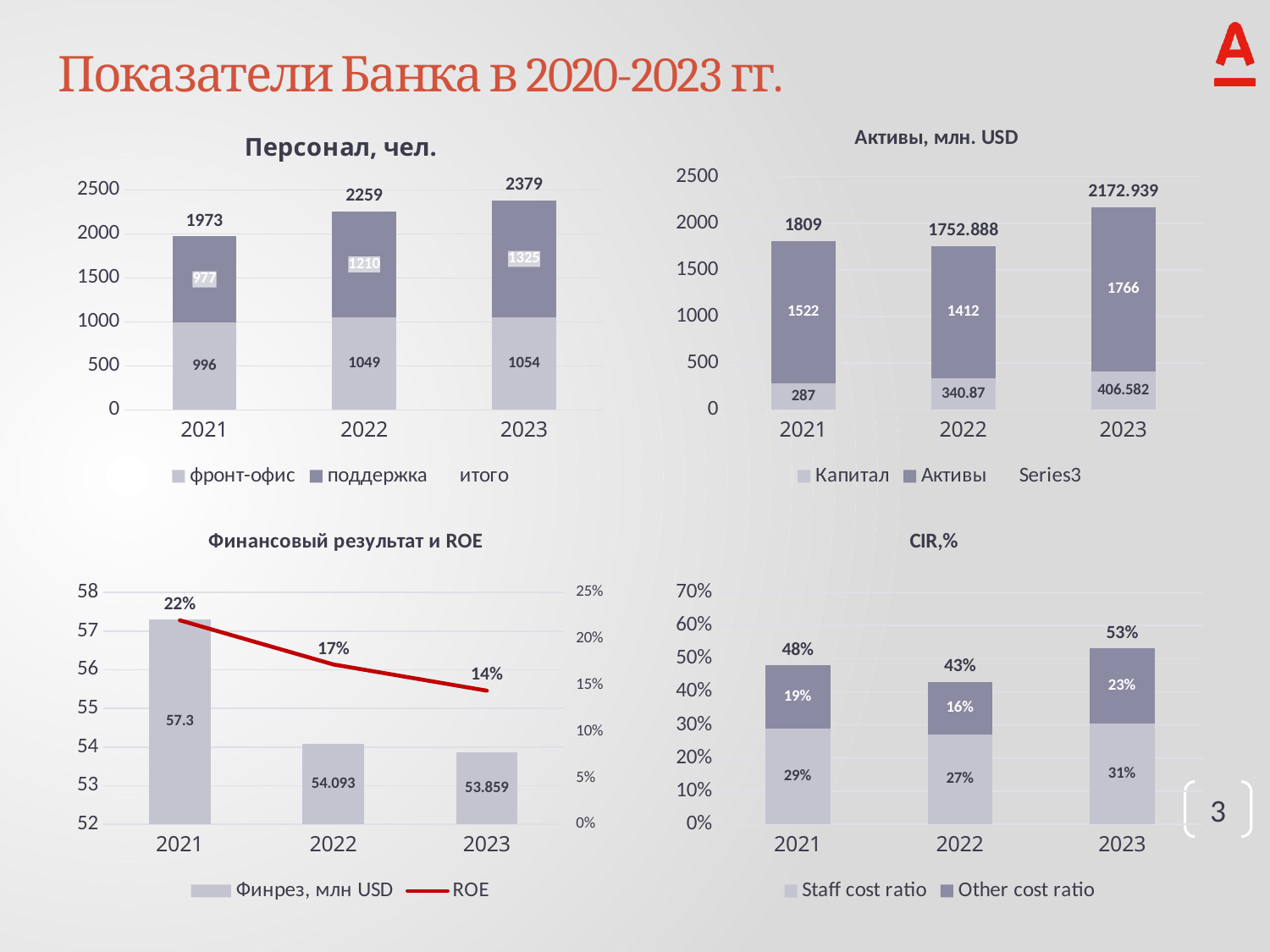
In the 'CIR,%' chart, which is larger: the Other cost ratio for 2021 or for 2022? 2021 In the 'Персонал, чел.' chart, what is the total (итого) for 2022? 2259 In the 'Персонал, чел.' chart, what is the difference between the фронт-офис values for 2023 and 2021? 58 In the 'Активы, млн. USD' chart, is the Активы value for 2023 greater or less than 1500? greater In the 'Финансовый результат и ROE' chart, which year has the highest Финрез value? 2021 In the 'Финансовый результат и ROE' chart, what is the ROE for 2022? 17% In the 'Активы, млн. USD' chart, which year has the lowest total? 2022 In the 'Персонал, чел.' chart, what is the value of поддержка for 2023? 1325 In the 'CIR,%' chart, what is the Staff cost ratio for 2023? 31% In the 'Финансовый результат и ROE' chart, does ROE rise or fall from 2021 to 2023? fall How many series does the legend of the 'CIR,%' chart list? 2 In the 'Активы, млн. USD' chart, what is the value of Капитал for 2022? 340.87